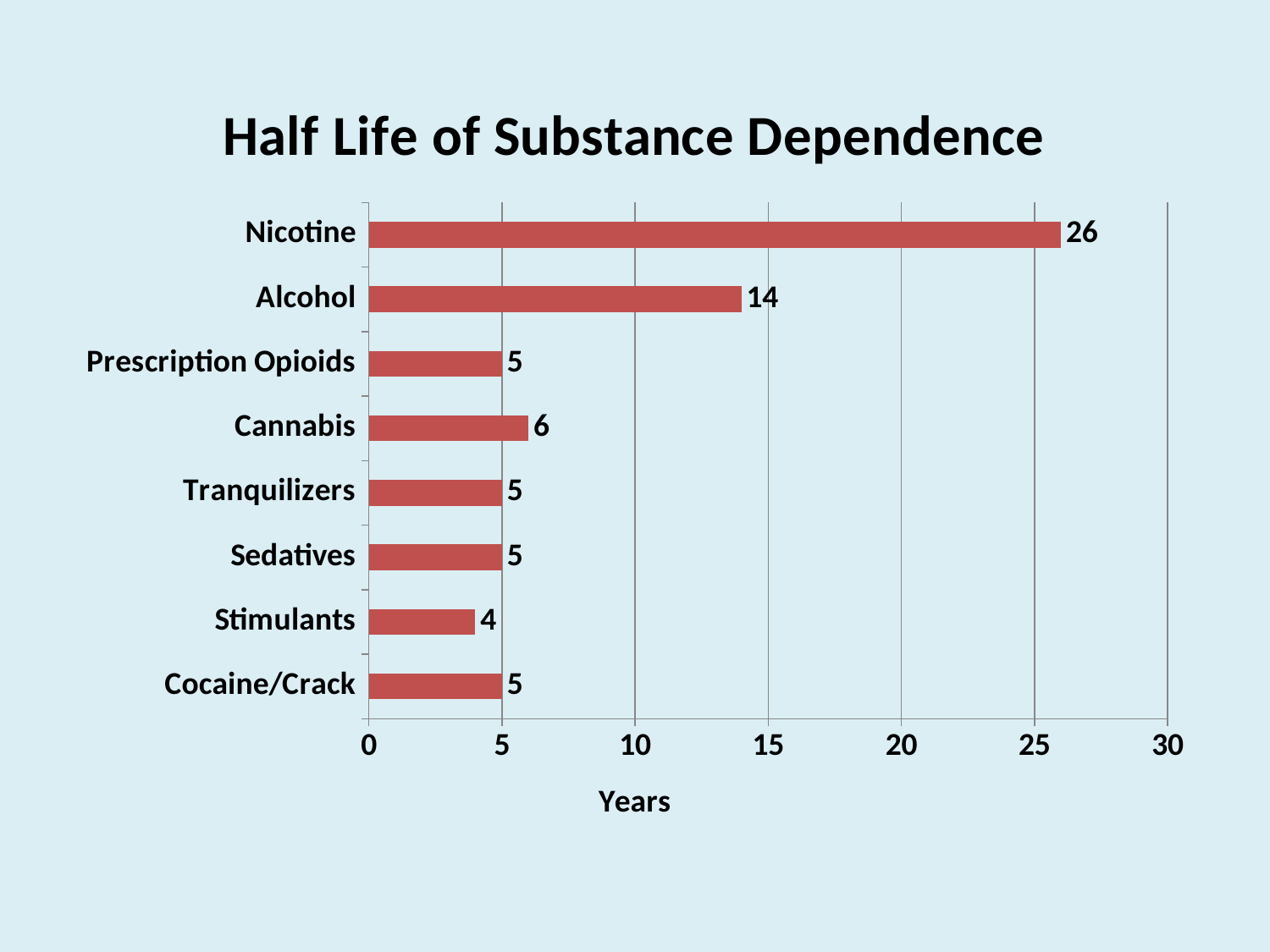
What is the value shown for Stimulants? 4 Is the value for Alcohol greater or less than 10? greater What is the label of the horizontal axis? Years Which substance has the highest half life of dependence? Nicotine What is the value shown for Cannabis? 6 Which substance has the lowest half life of dependence? Stimulants How many substances are shown in the chart? 8 What is the difference in years between Nicotine and Alcohol? 12 Which has a larger value, Cannabis or Prescription Opioids? Cannabis What is the half life of substance dependence for Nicotine? 26 What is the value shown for Alcohol? 14 What kind of chart is shown on the slide? Bar chart